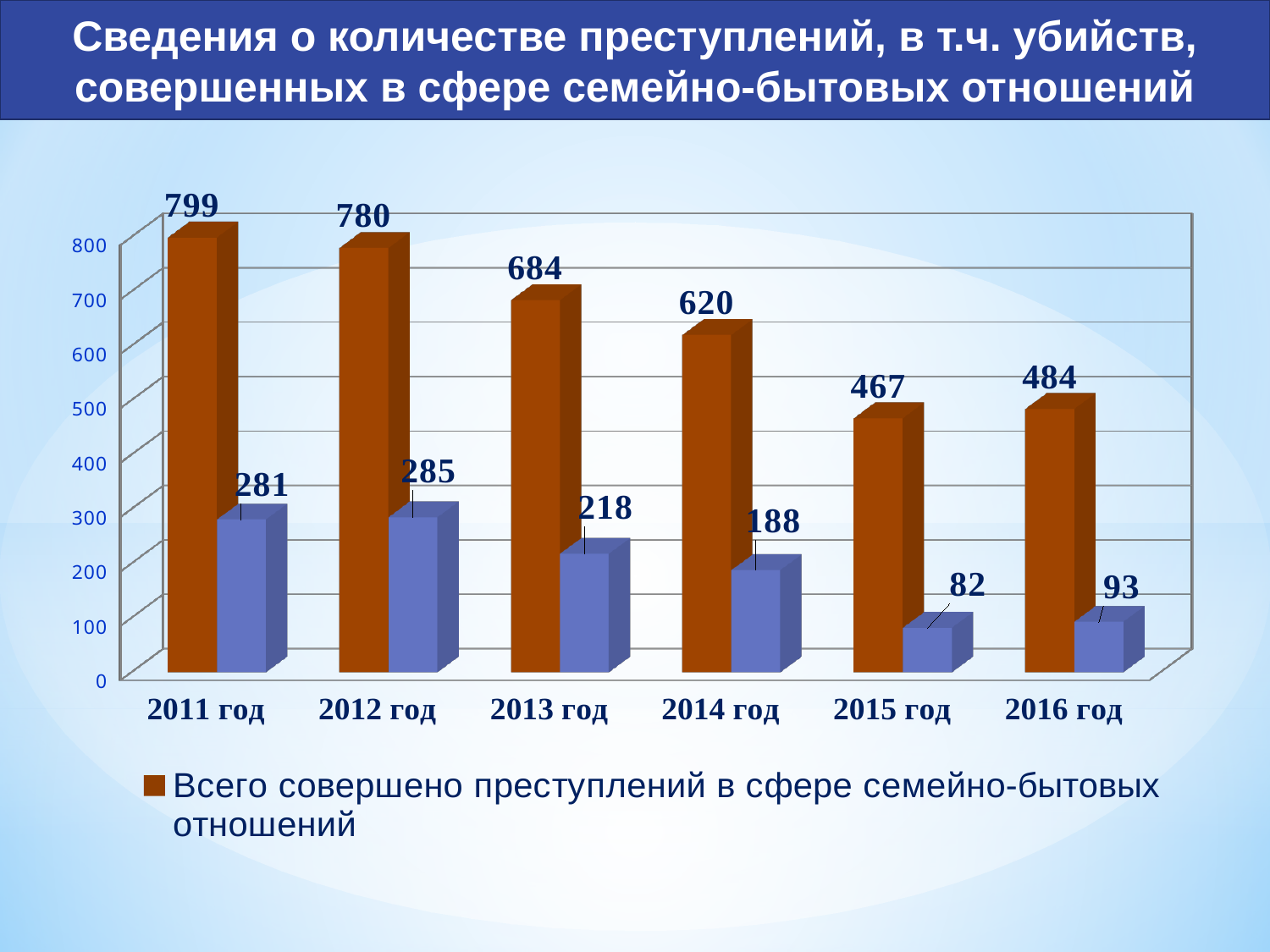
What is the value of the brown series (Всего совершено преступлений в сфере семейно-бытовых отношений) for 2011 год? 799 What is the difference between the brown and blue values for 2013 год? 466 Which is larger: the blue series value for 2012 год or for 2011 год? 2012 год What is the value of the brown series for 2016 год? 484 How many years (categories) are shown on the x axis? 6 Does the brown series generally rise or fall from 2011 год to 2015 год? Fall In which year is the brown series (total crimes) highest? 2011 год By how much did the brown series value change from 2011 год to 2012 год? 19 What is the value of the blue series for 2014 год? 188 How many series does the legend list? 1 What kind of chart is shown on the slide? Bar chart In which year is the blue series lowest? 2015 год